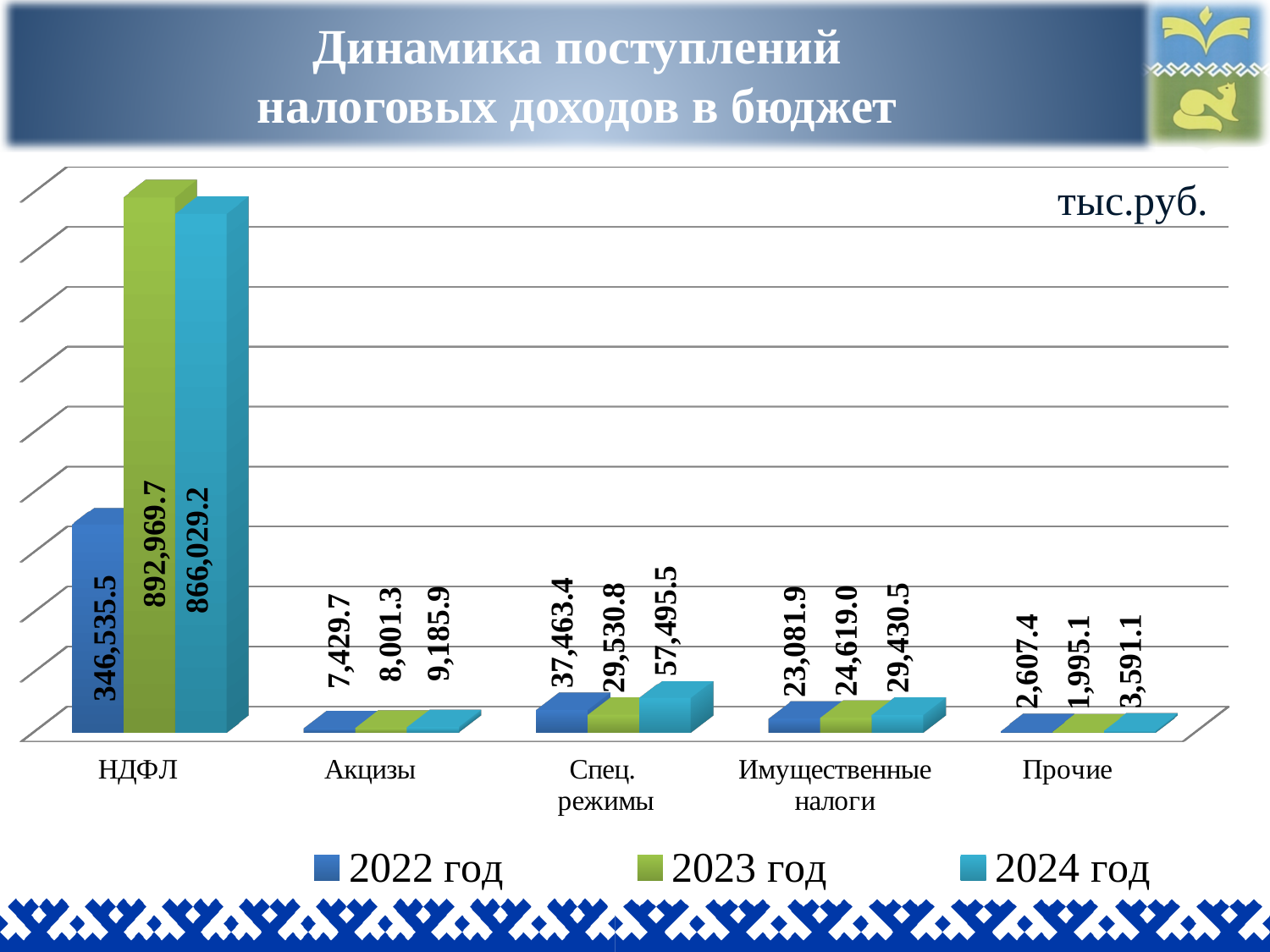
What is the difference between the 2024 год and 2022 год values for Спец. режимы? 20,032.1 What is the value for НДФЛ in 2022 год? 346,535.5 How many categories are shown on the x axis? 5 How many series does the legend list? 3 What is the value for Имущественные налоги in 2023 год? 24,619.0 Which is larger for Спец. режимы: the 2022 год value or the 2023 год value? 2022 год Which category has the lowest value in 2022 год? Прочие What kind of chart is shown on the slide? Bar chart Which category has the highest value in 2024 год? НДФЛ What is the value for Спец. режимы in 2024 год? 57,495.5 What is the value for Прочие in 2023 год? 1,995.1 What is the difference between the 2023 год and 2024 год values for НДФЛ? 26,940.5